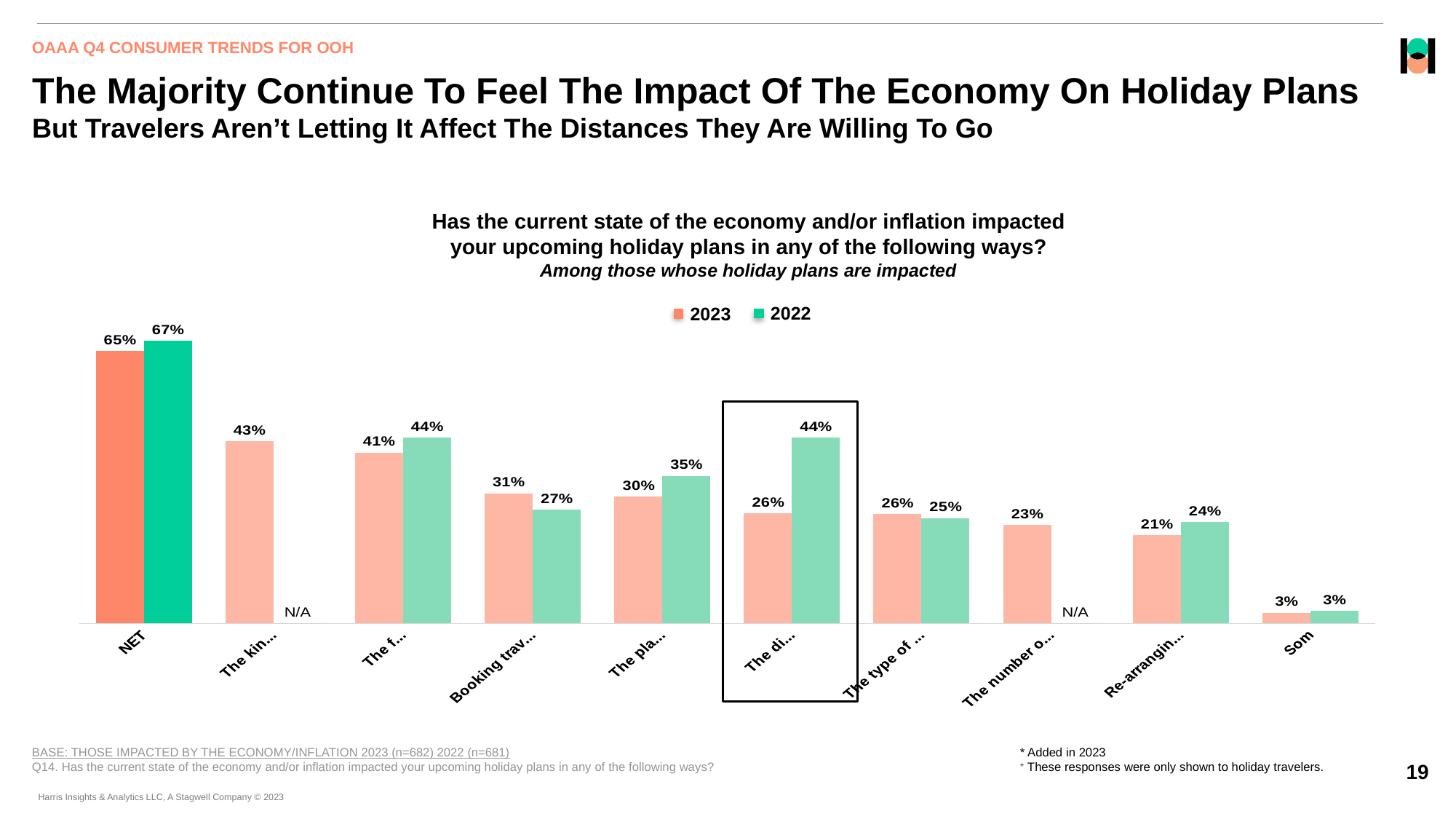
What is the 2022 value for NET? 67% Which category has the highest 2022 value? NET What is the 2023 value for NET? 65% What are the two series named in the legend? 2023 and 2022 For NET, which year has the larger value, 2023 or 2022? 2022 What is the lowest 2023 value shown on the chart? 3% Which category has the highest 2023 value? NET What is the difference between the 2022 and 2023 values for NET? 2% How many categories show N/A for the 2022 series? 2 How many categories are shown on the x axis? 10 What type of chart is shown on the slide? bar chart How many series does the legend list? 2